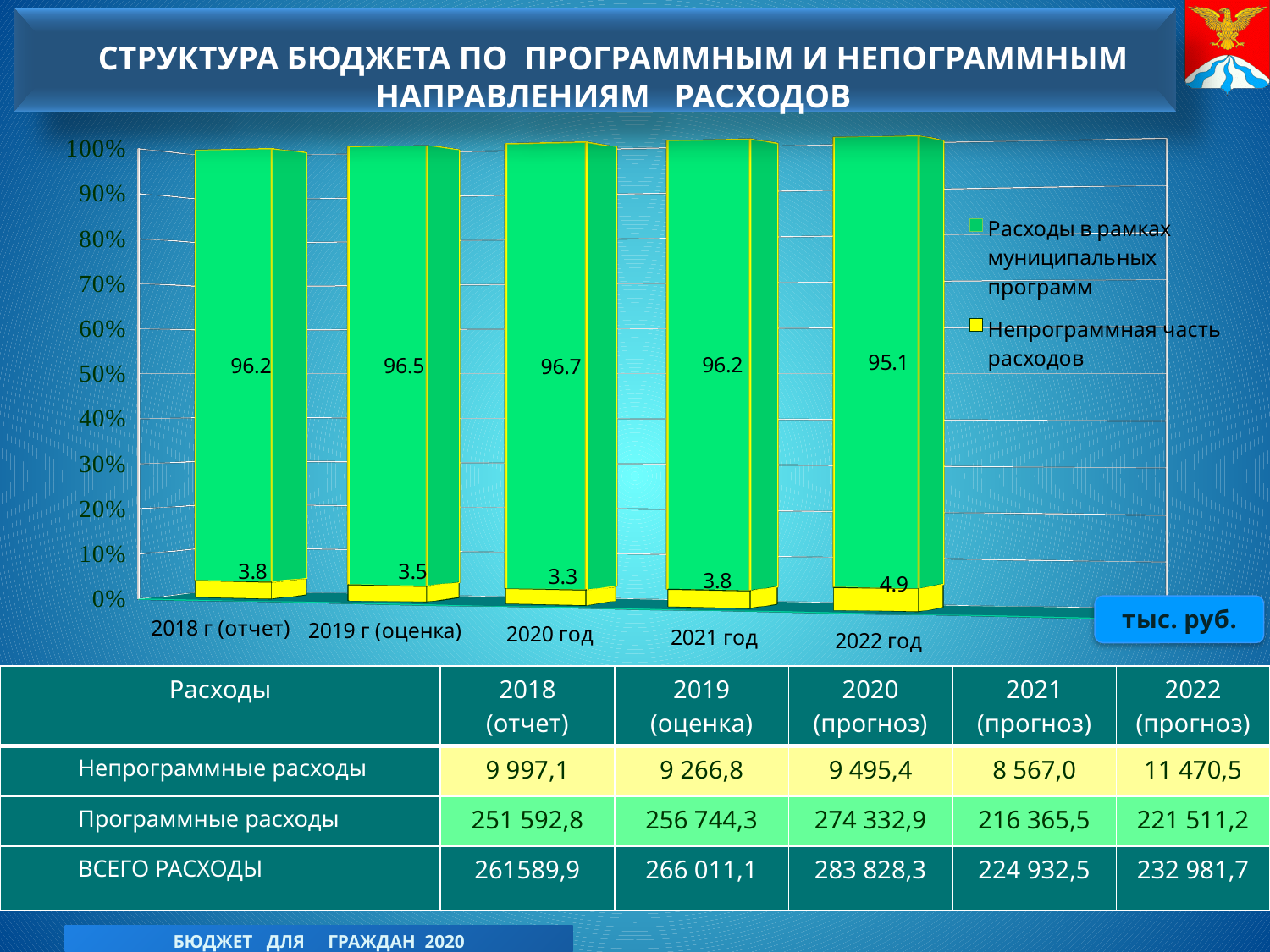
How many years (categories) are shown on the x axis of the chart? 5 What is the value of the yellow series (Непрограммная часть расходов) for 2022 год? 4.9 Which colour represents Непрограммная часть расходов in the chart? Yellow What is the difference between the Непрограммная часть расходов values for 2022 год and 2020 год? 1.6 What is the value of Расходы в рамках муниципальных программ for 2019 г (оценка)? 96.5 What is the value of the green series (Расходы в рамках муниципальных программ) for 2020 год? 96.7 In which year is the value of Непрограммная часть расходов the highest? 2022 год What is the value of Непрограммная часть расходов for 2018 г (отчет)? 3.8 In which year is the value of Расходы в рамках муниципальных программ the lowest? 2022 год What kind of chart is shown on the slide? Stacked bar chart How many series does the chart legend list? 2 Which is larger: the Расходы в рамках муниципальных программ value for 2020 год or for 2021 год? 2020 год